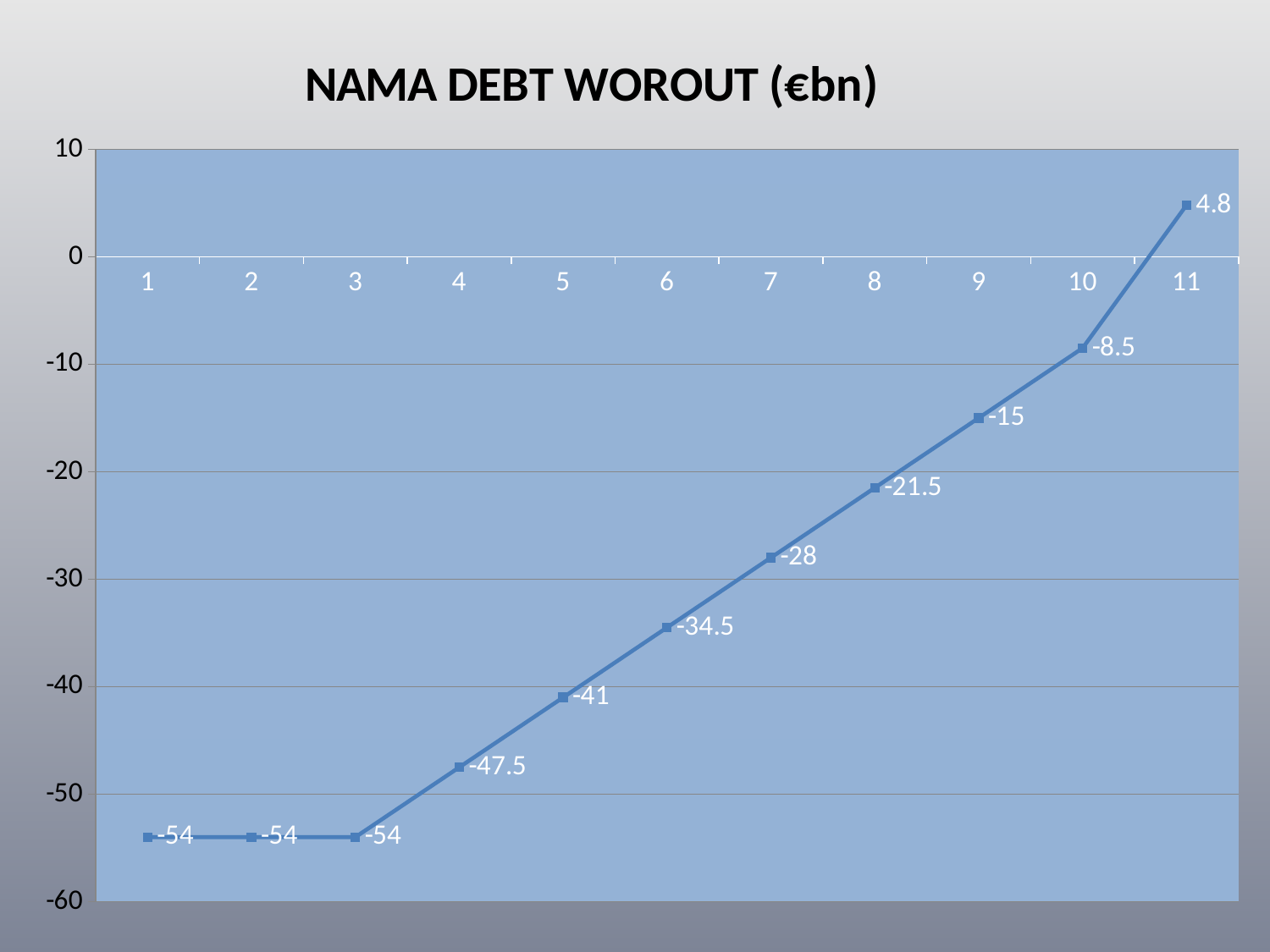
What is the title of the chart? NAMA DEBT WOROUT (€bn) What is the value at point 8? -21.5 What is the difference between the values at point 7 and point 6? 6.5 What is the value at point 11? 4.8 What kind of chart is shown on the slide? line chart What is the lowest value plotted on the chart? -54 What is the value at point 4? -47.5 How many data points are plotted on the chart? 11 Do the values rise or fall from point 3 to point 11? rise Is the value at point 10 greater or less than -10? greater Which point has the highest value? 11 Which is larger, the value at point 9 or the value at point 5? point 9